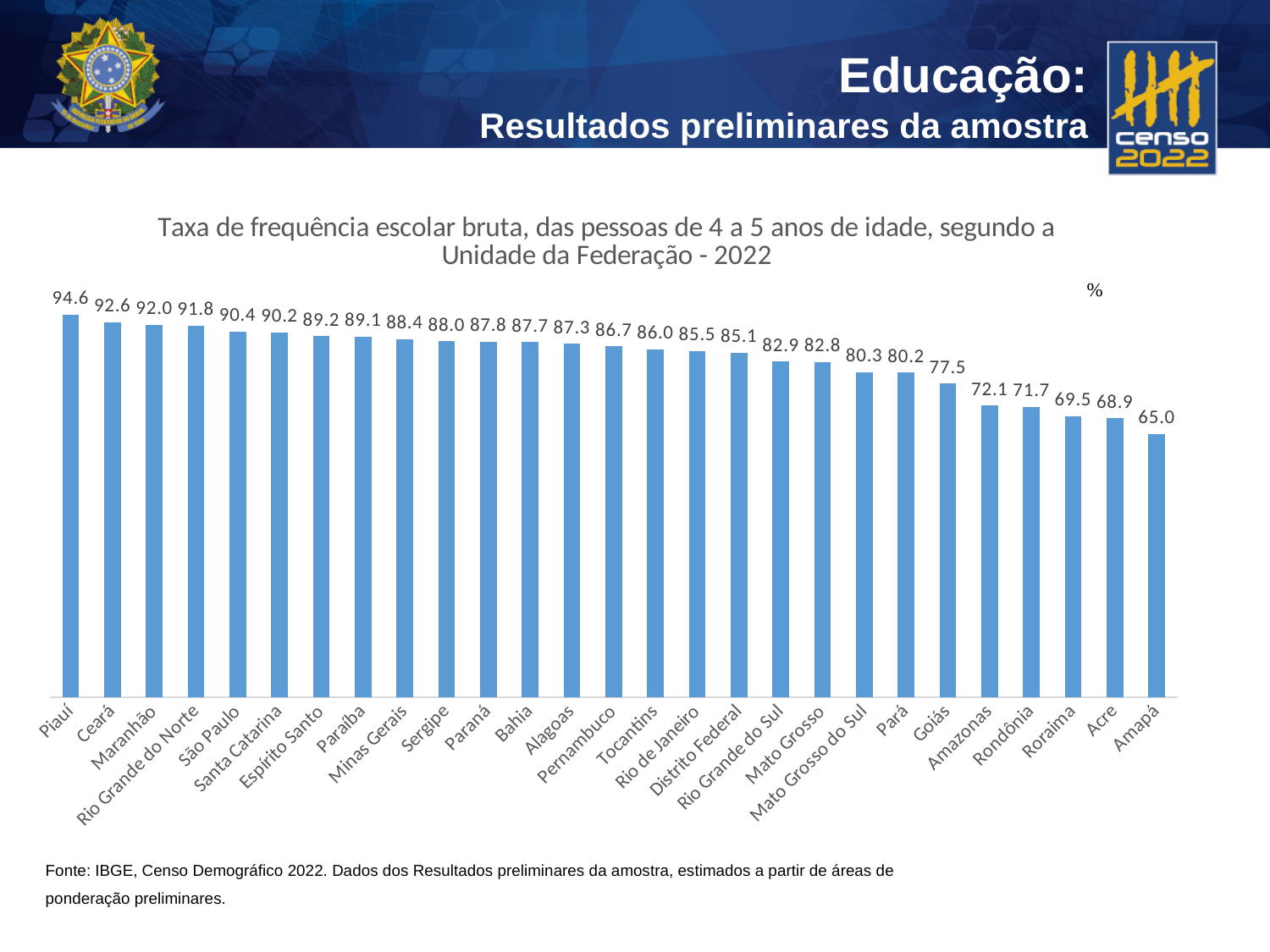
What is the difference between the values for Piauí and Amapá? 29.6 What is the value for Goiás? 77.5 What unit is indicated at the top right of the chart? % What is the value for Piauí? 94.6 Which has a larger value, Ceará or Amazonas? Ceará Do the values rise or fall from left to right along the x axis? Fall What is the value for Distrito Federal? 85.1 Which Unidade da Federação has the lowest value? Amapá What is the difference between the values for São Paulo and Rio de Janeiro? 4.9 Which Unidade da Federação has the highest value? Piauí What kind of chart is shown on the slide? Bar chart How many Unidades da Federação are shown in the chart? 27